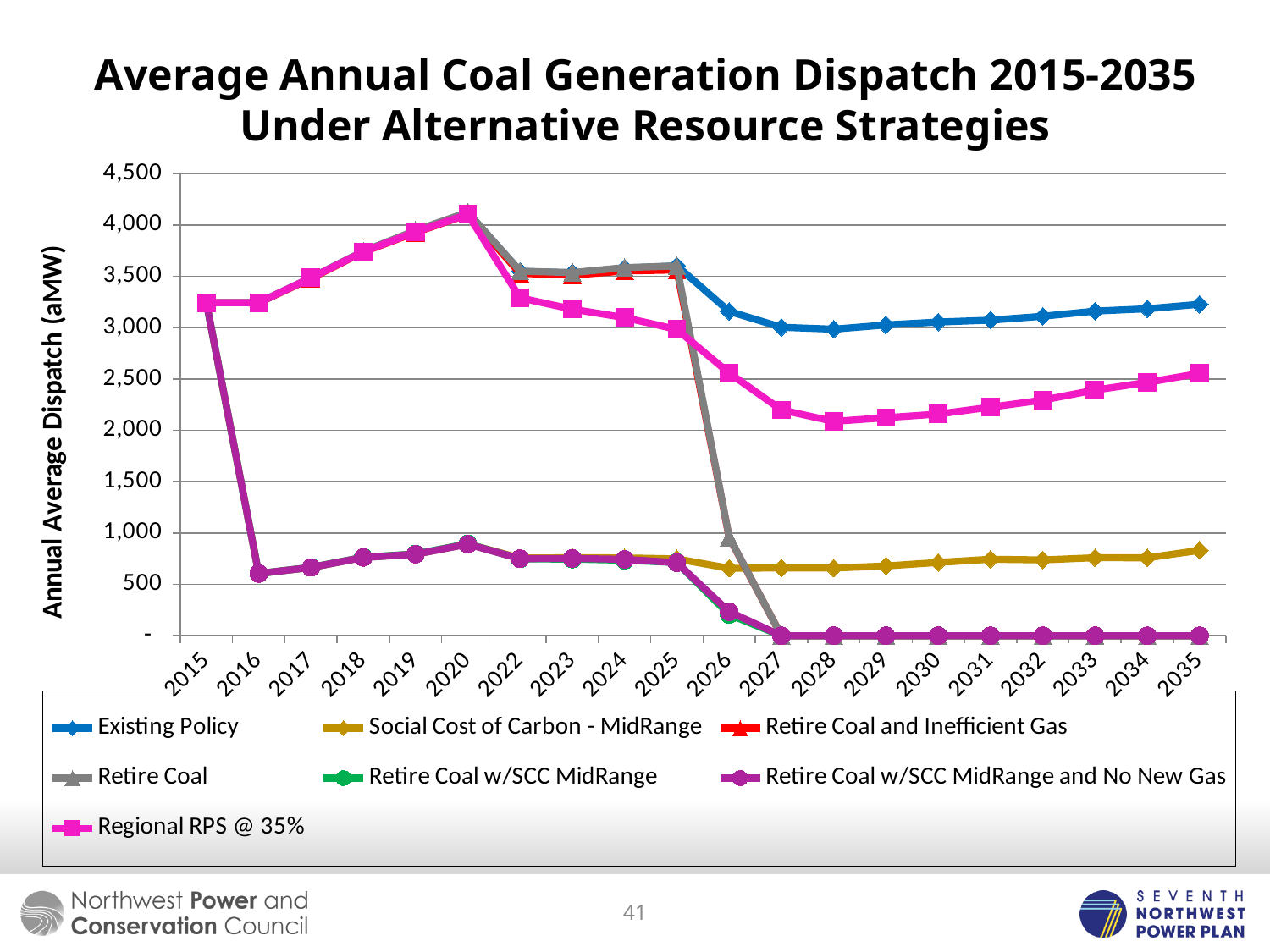
What kind of chart is shown on the slide? Line chart Is the value for Retire Coal w/SCC MidRange and No New Gas in 2016 greater or less than 1,000? less Is the value for Existing Policy in 2035 greater or less than 3,000? greater How many years are shown along the x axis? 20 Does the Regional RPS @ 35% line rise or fall from 2028 to 2035? rise In 2035, which is larger: Existing Policy or Regional RPS @ 35%? Existing Policy What is the label of the y axis? Annual Average Dispatch (aMW) Is the value for Retire Coal in 2020 greater or less than 4,000? greater Which series has the highest value in 2035? Existing Policy How many series does the legend list? 7